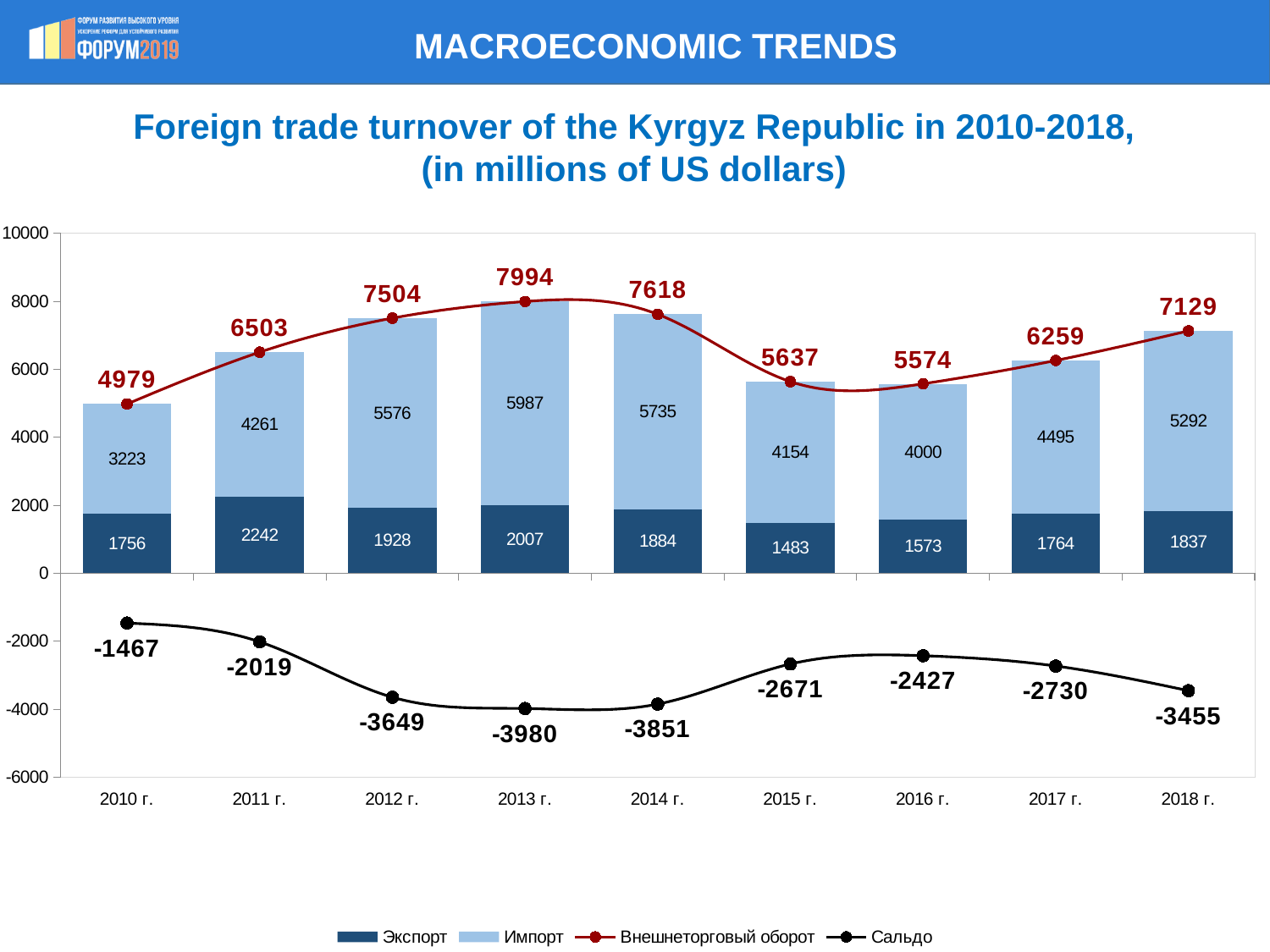
Does the Внешнеторговый оборот (foreign trade turnover) line rise or fall from 2014 г. to 2016 г.? fall What is the value of the Импорт (import) series for 2013 г.? 5987 In which year is the Экспорт (export) value the lowest? 2015 г. What is the value of the Сальдо (balance) line for 2015 г.? -2671 Which is larger: the Импорт (import) value for 2014 г. or for 2018 г.? 2014 г. What is the total of the stacked bar (Экспорт plus Импорт) for 2010 г.? 4979 How many series does the legend list? 4 What is the difference between the Импорт (import) values for 2012 г. and 2011 г.? 1315 In which year does the Внешнеторговый оборот (foreign trade turnover) line reach its highest value? 2013 г. How many years are shown on the x axis of the chart? 9 What is the value of the Внешнеторговый оборот (foreign trade turnover) line for 2018 г.? 7129 What is the value of the Экспорт (export) series for 2011 г.? 2242